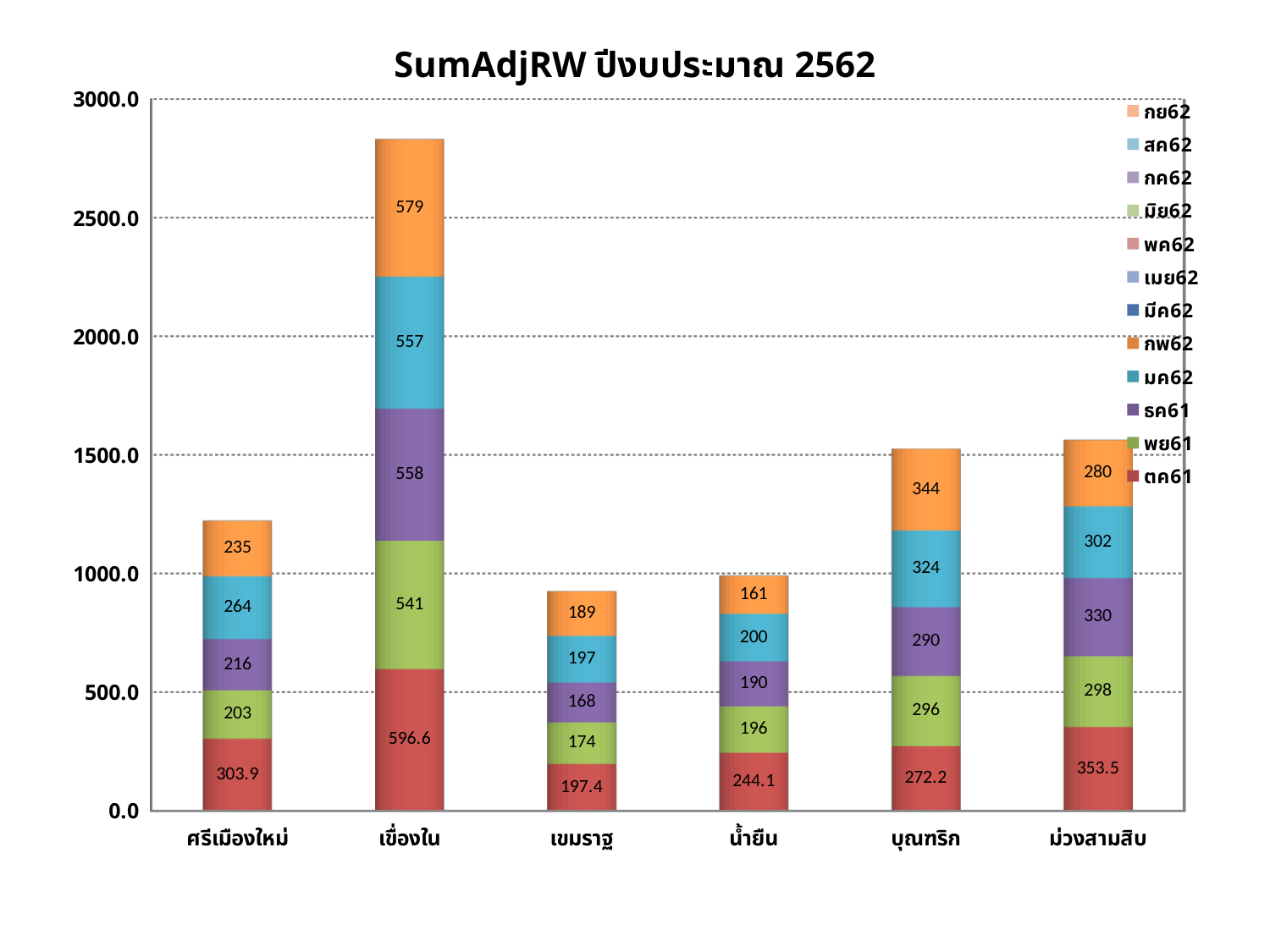
Is the total stacked bar for บุณฑริก greater or less than 1500? greater Which category has the shortest stacked bar? เขมราฐ What is the title of the chart? SumAdjRW ปีงบประมาณ 2562 What kind of chart is shown on the slide? Stacked bar chart How many categories are shown on the x axis? 6 How many series does the legend list? 12 What is the difference between the ตค61 values for ม่วงสามสิบ and เขมราฐ? 156.1 What is the total of the stacked bar for ศรีเมืองใหม่? 1221.9 What is the ตค61 value for เขื่องใน? 596.6 What is the กพ62 value for บุณฑริก? 344 What is the มค62 value for น้ำยืน? 200 Which category has the tallest stacked bar? เขื่องใน